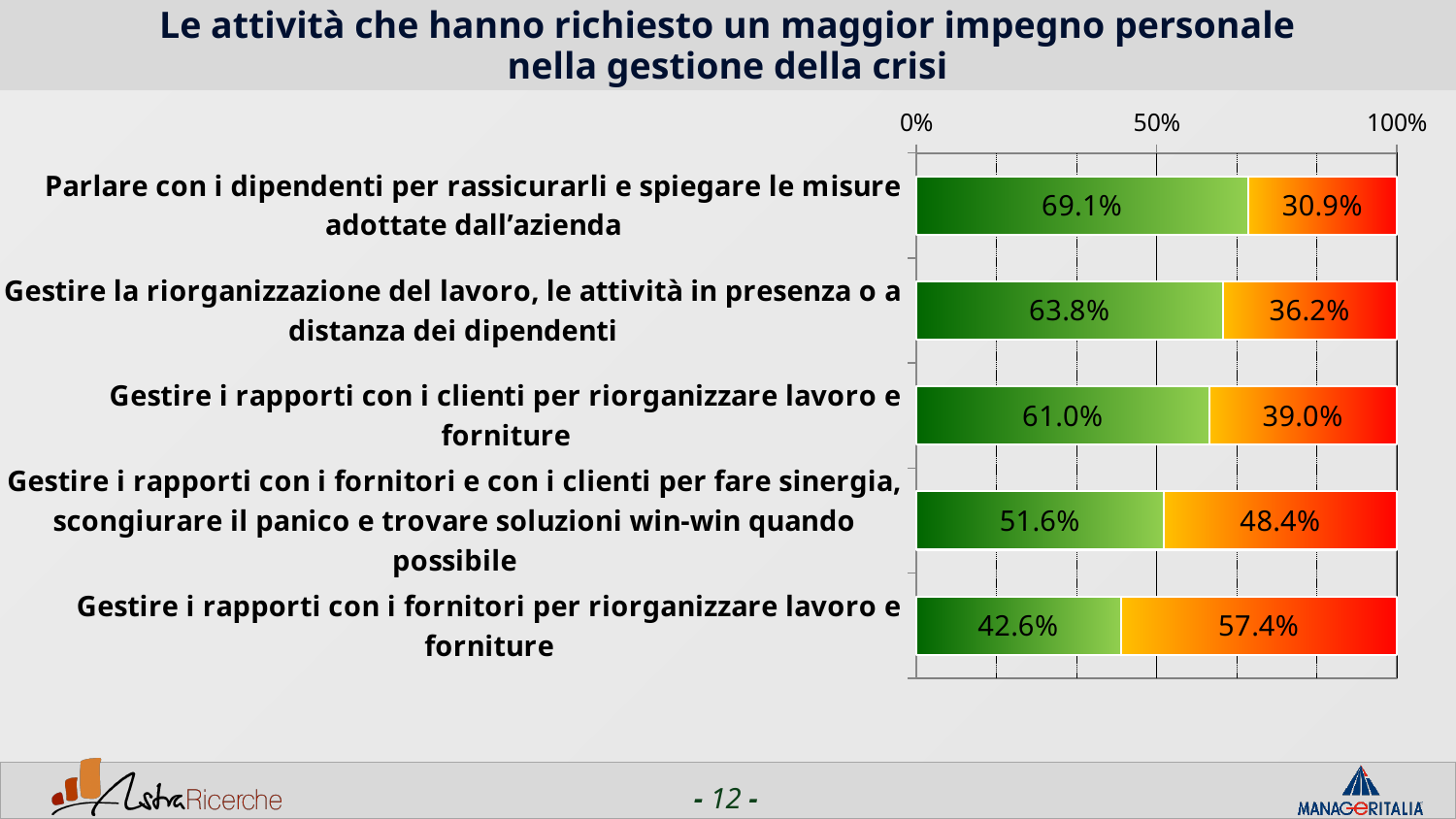
How many categories are shown in the chart? 5 Which is larger: the green segment for "Gestire i rapporti con i fornitori e con i clienti per fare sinergia..." or the green segment for "Gestire i rapporti con i clienti per riorganizzare lavoro e forniture"? Gestire i rapporti con i clienti per riorganizzare lavoro e forniture Is the green-segment value for "Gestire i rapporti con i fornitori per riorganizzare lavoro e forniture" greater or less than 50%? less What is the orange/red-segment value for "Gestire i rapporti con i fornitori per riorganizzare lavoro e forniture"? 57.4% What is the difference between the green-segment values for "Parlare con i dipendenti..." (69.1%) and "Gestire la riorganizzazione del lavoro..." (63.8%)? 5.3% What is the title of the chart on the slide? Le attività che hanno richiesto un maggior impegno personale nella gestione della crisi What kind of chart is shown on the slide? Stacked horizontal bar chart What is the total of the two segments for "Gestire la riorganizzazione del lavoro, le attività in presenza o a distanza dei dipendenti"? 100% What is the green-segment value for "Parlare con i dipendenti per rassicurarli e spiegare le misure adottate dall'azienda"? 69.1% What is the green-segment value for "Gestire i rapporti con i clienti per riorganizzare lavoro e forniture"? 61.0% Which category has the lowest green-segment value? Gestire i rapporti con i fornitori per riorganizzare lavoro e forniture Which category has the highest green-segment value? Parlare con i dipendenti per rassicurarli e spiegare le misure adottate dall'azienda